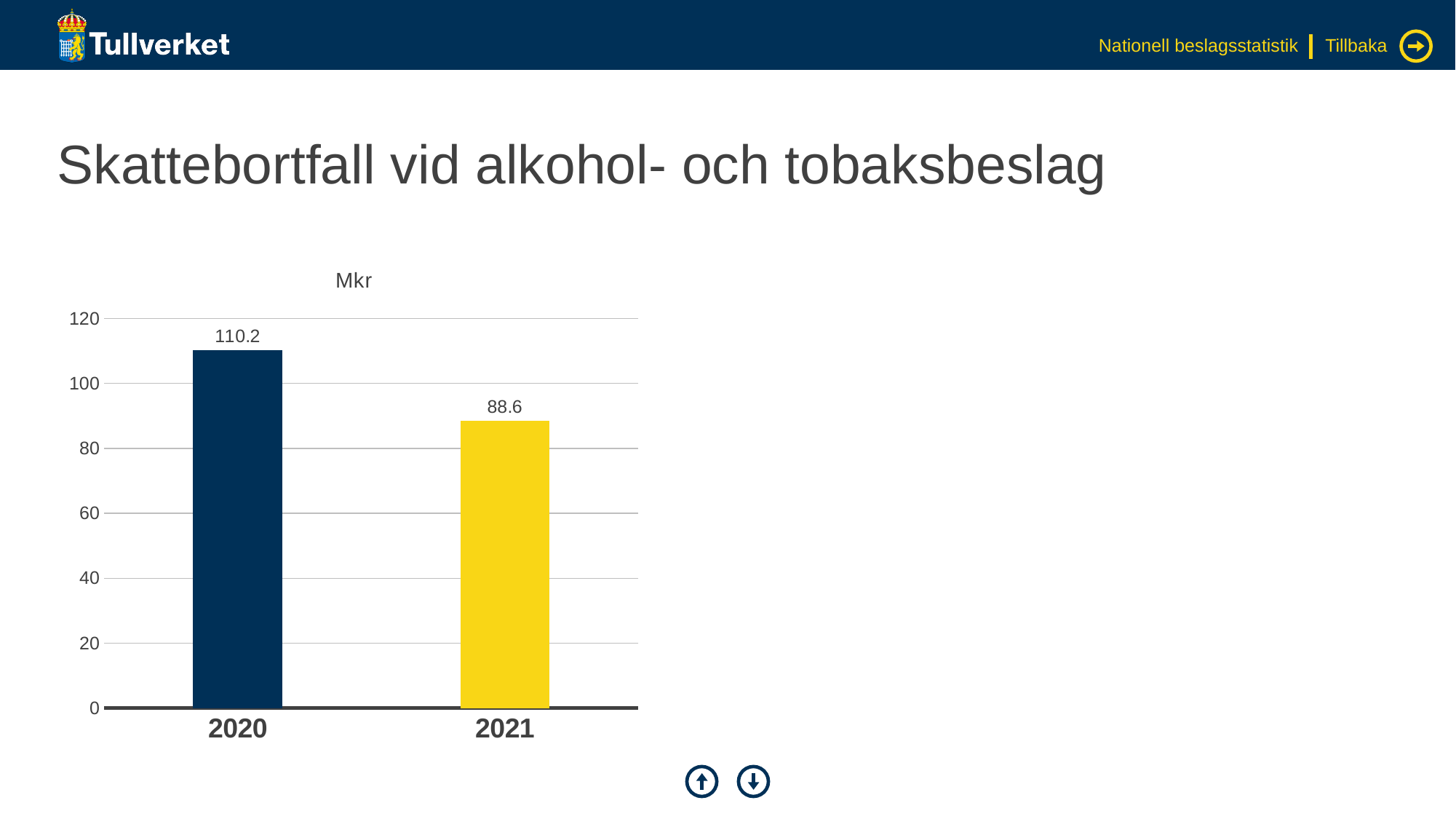
What is the value for 2021? 88.6 What kind of chart is shown on the slide? bar chart Which year has the highest value? 2020 What is the value for 2020? 110.2 Do the values rise or fall from 2020 to 2021? fall Which is larger, the value for 2020 or the value for 2021? 2020 What unit label is shown above the chart? Mkr How many years are shown on the chart? 2 Is the value for 2020 greater or less than 100? greater What is the difference between the values for 2020 and 2021? 21.6 Which year has the lowest value? 2021 Is the value for 2021 greater or less than 100? less